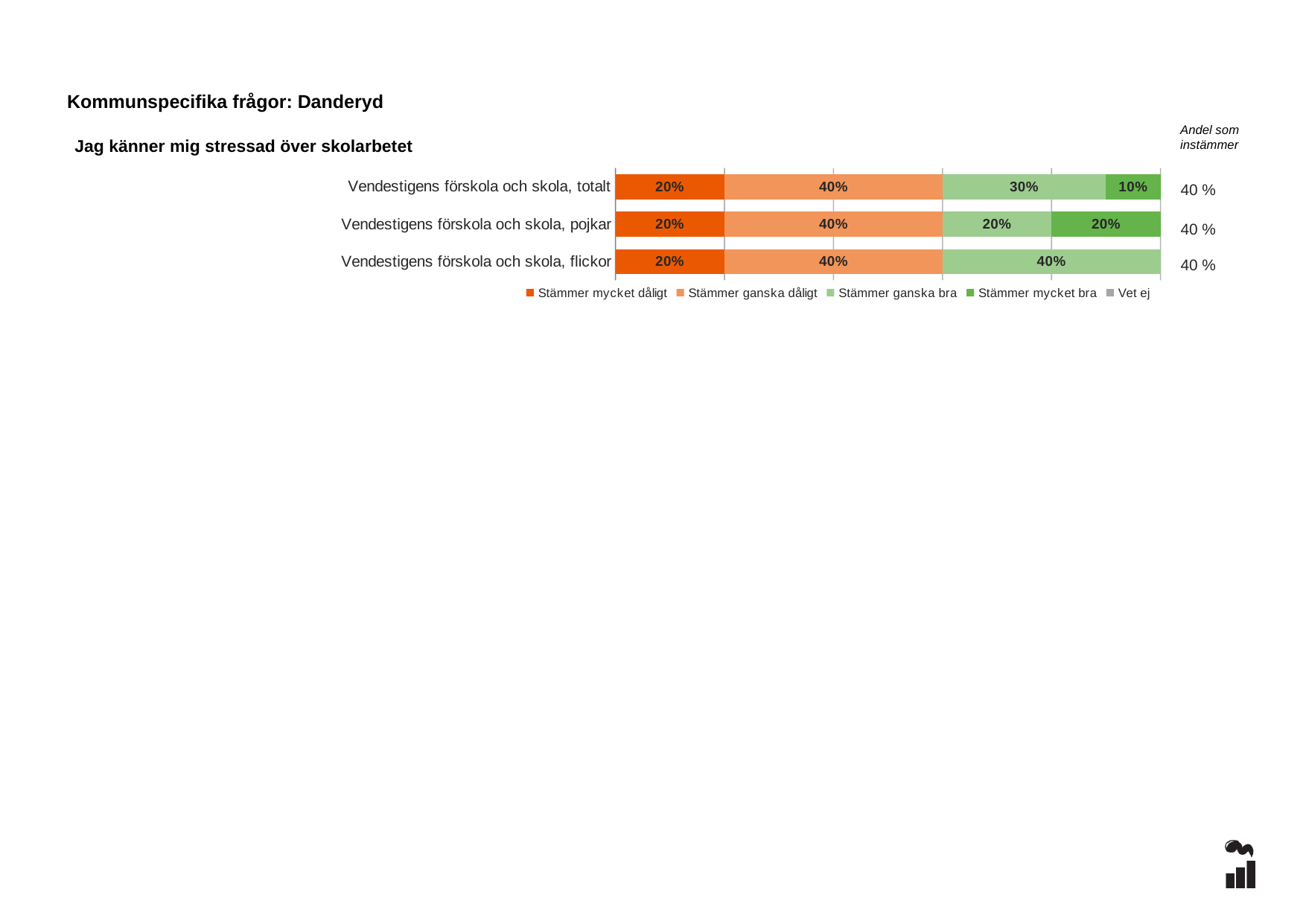
What is the "Andel som instämmer" value shown for "Vendestigens förskola och skola, pojkar"? 40 % How many series does the legend list? 5 What is the value of "Stämmer ganska bra" for "Vendestigens förskola och skola, flickor"? 40% Which category has the highest value for "Stämmer ganska bra"? Vendestigens förskola och skola, flickor What is the value of "Stämmer ganska bra" for "Vendestigens förskola och skola, totalt"? 30% Which is larger: "Stämmer mycket bra" for "Vendestigens förskola och skola, pojkar" or for "Vendestigens förskola och skola, totalt"? Vendestigens förskola och skola, pojkar Which category has the lowest value for "Stämmer mycket bra" among those with a labelled segment? Vendestigens förskola och skola, totalt What is the value of "Stämmer mycket dåligt" for "Vendestigens förskola och skola, totalt"? 20% What kind of chart is shown on the slide? Stacked bar chart What is the value of "Stämmer mycket bra" for "Vendestigens förskola och skola, pojkar"? 20% How many categories are shown in the chart? 3 What is the difference between the "Stämmer ganska bra" values for "Vendestigens förskola och skola, flickor" and "Vendestigens förskola och skola, pojkar"? 20%